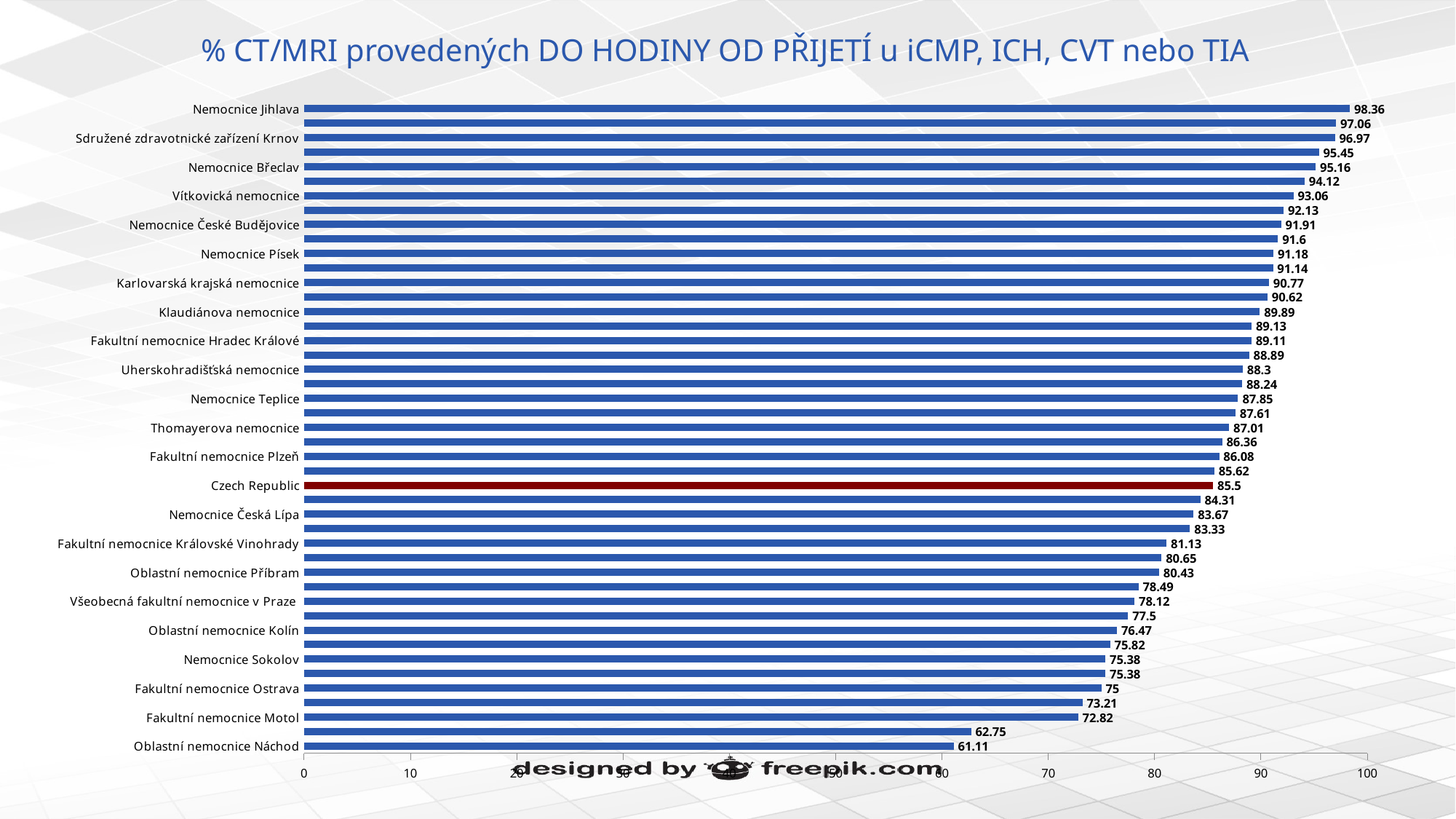
Which is larger, the value for Nemocnice Písek or the value for Nemocnice Sokolov? Nemocnice Písek What is the value for Oblastní nemocnice Náchod? 61.11 Do the values rise or fall going from the top bar to the bottom bar? fall What is the value for Fakultní nemocnice Motol? 72.82 Which labelled hospital has the highest value? Nemocnice Jihlava Which category's bar is coloured red instead of blue? Czech Republic Which labelled hospital has the lowest value? Oblastní nemocnice Náchod What is the value for Czech Republic? 85.5 What is the value for Nemocnice Jihlava? 98.36 What kind of chart is shown on the slide? bar chart What is the difference between the value for Nemocnice Jihlava and the value for Czech Republic? 12.86 Is the value for Fakultní nemocnice Motol greater or less than 80? less